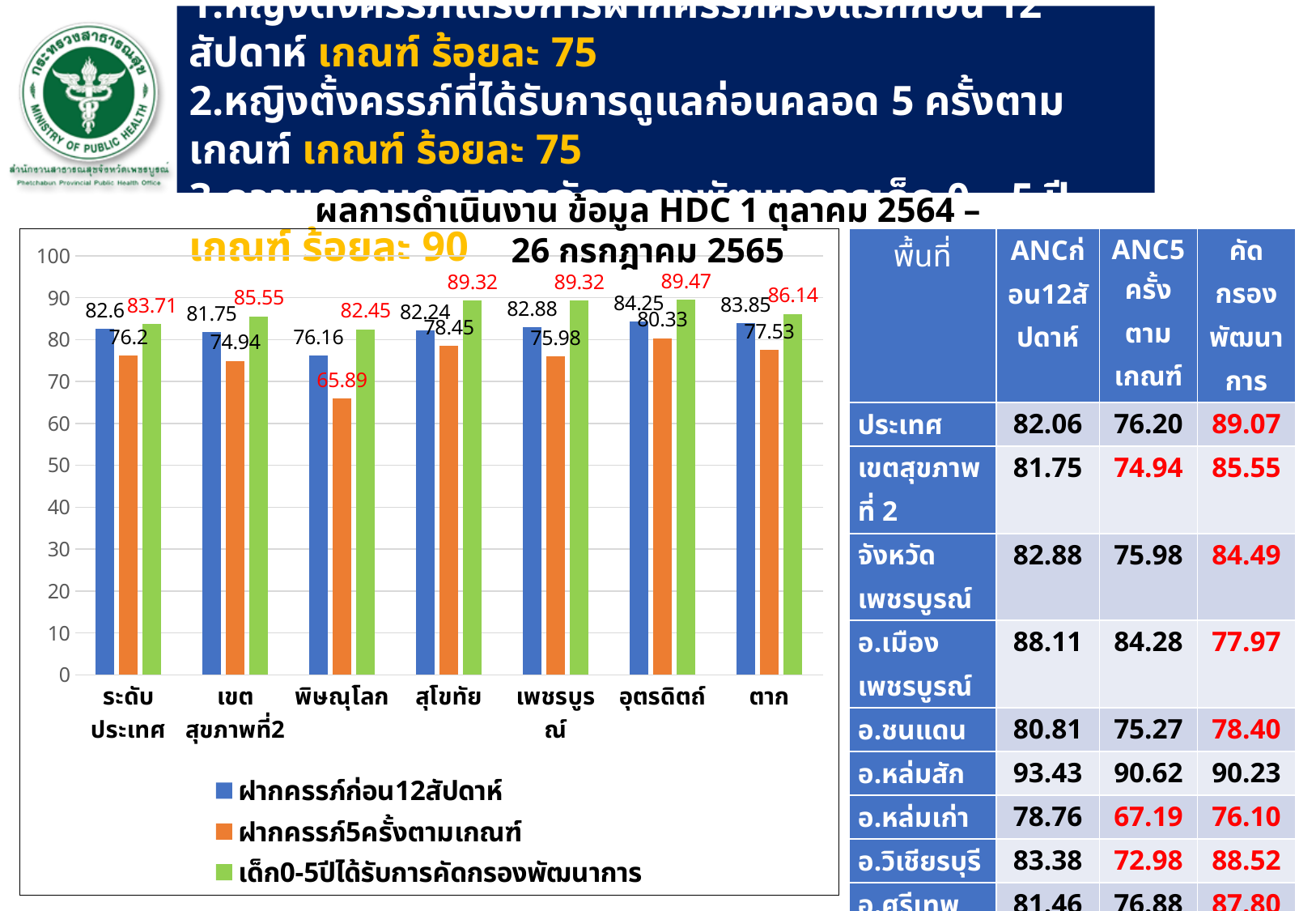
How many categories are shown on the x axis of the chart? 7 What is the difference between ฝากครรภ์ก่อน12สัปดาห์ and ฝากครรภ์5ครั้งตามเกณฑ์ for ระดับประเทศ? 6.4 How many series does the chart legend list? 3 Is the value of ฝากครรภ์5ครั้งตามเกณฑ์ for พิษณุโลก greater or less than 70? less Which colour represents ฝากครรภ์5ครั้งตามเกณฑ์ in the chart? orange Which is larger for สุโขทัย: ฝากครรภ์ก่อน12สัปดาห์ or เด็ก0-5ปีได้รับการคัดกรองพัฒนาการ? เด็ก0-5ปีได้รับการคัดกรองพัฒนาการ What kind of chart is shown on the slide? bar chart Which category has the highest value for ฝากครรภ์5ครั้งตามเกณฑ์? อุตรดิตถ์ Which category has the lowest value for ฝากครรภ์ก่อน12สัปดาห์? พิษณุโลก What is the value of เด็ก0-5ปีได้รับการคัดกรองพัฒนาการ for ตาก? 86.14 What is the value of ฝากครรภ์5ครั้งตามเกณฑ์ for พิษณุโลก? 65.89 What is the value of ฝากครรภ์ก่อน12สัปดาห์ for เพชรบูรณ์? 82.88